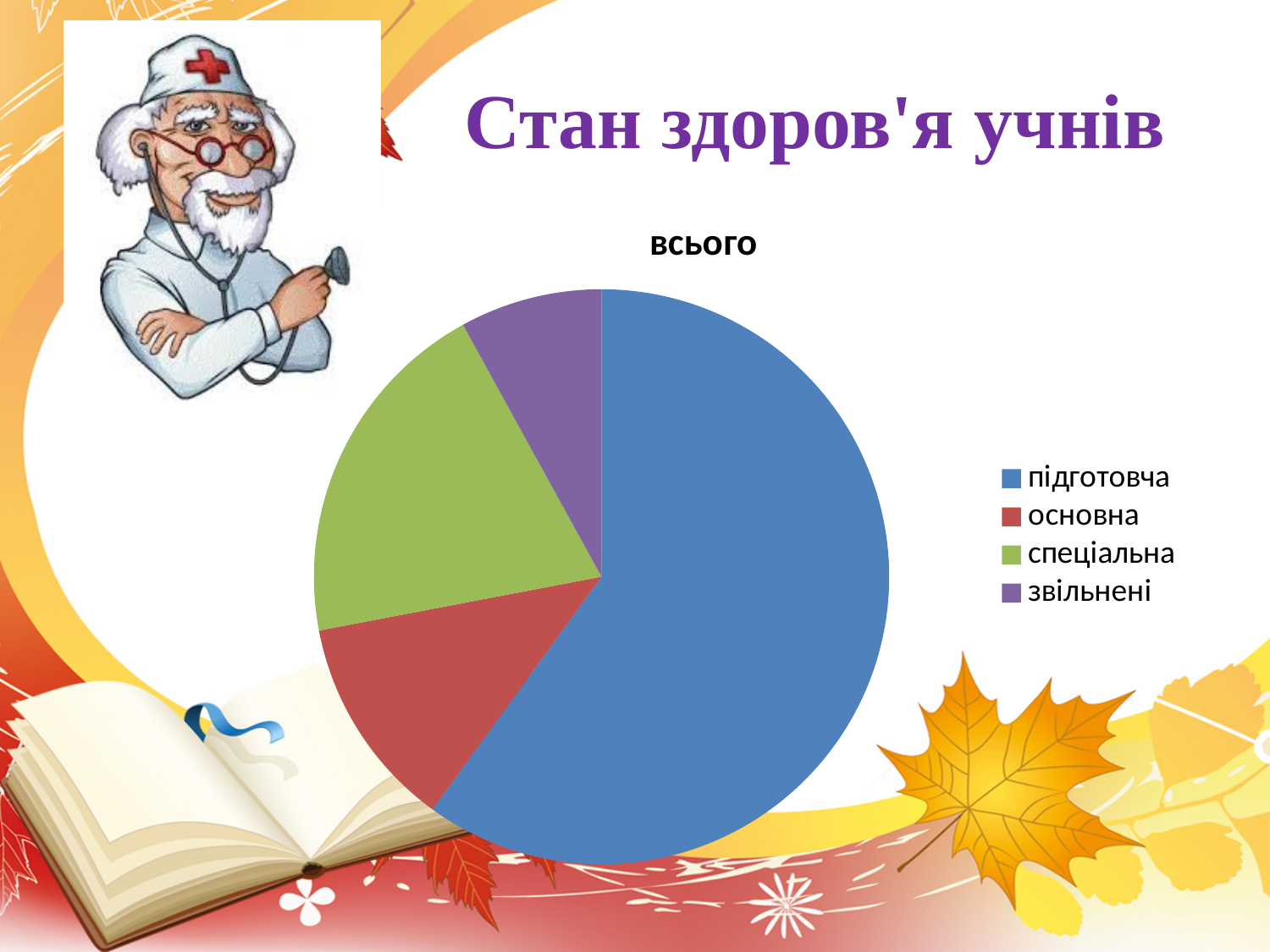
How many entries does the legend of the pie chart list? 4 Which category has the smallest slice of the pie chart? звільнені What colour is the slice for спеціальна in the pie chart? green Which slice is larger, підготовча or спеціальна? підготовча Which slice is larger, спеціальна or звільнені? спеціальна Which category has the largest slice of the pie chart? підготовча What kind of chart is shown on the slide? pie chart What is the title of the pie chart? всього How many categories (slices) does the pie chart have? 4 Which slice is larger, підготовча or основна? підготовча Does the підготовча slice take up more or less than half of the pie? more